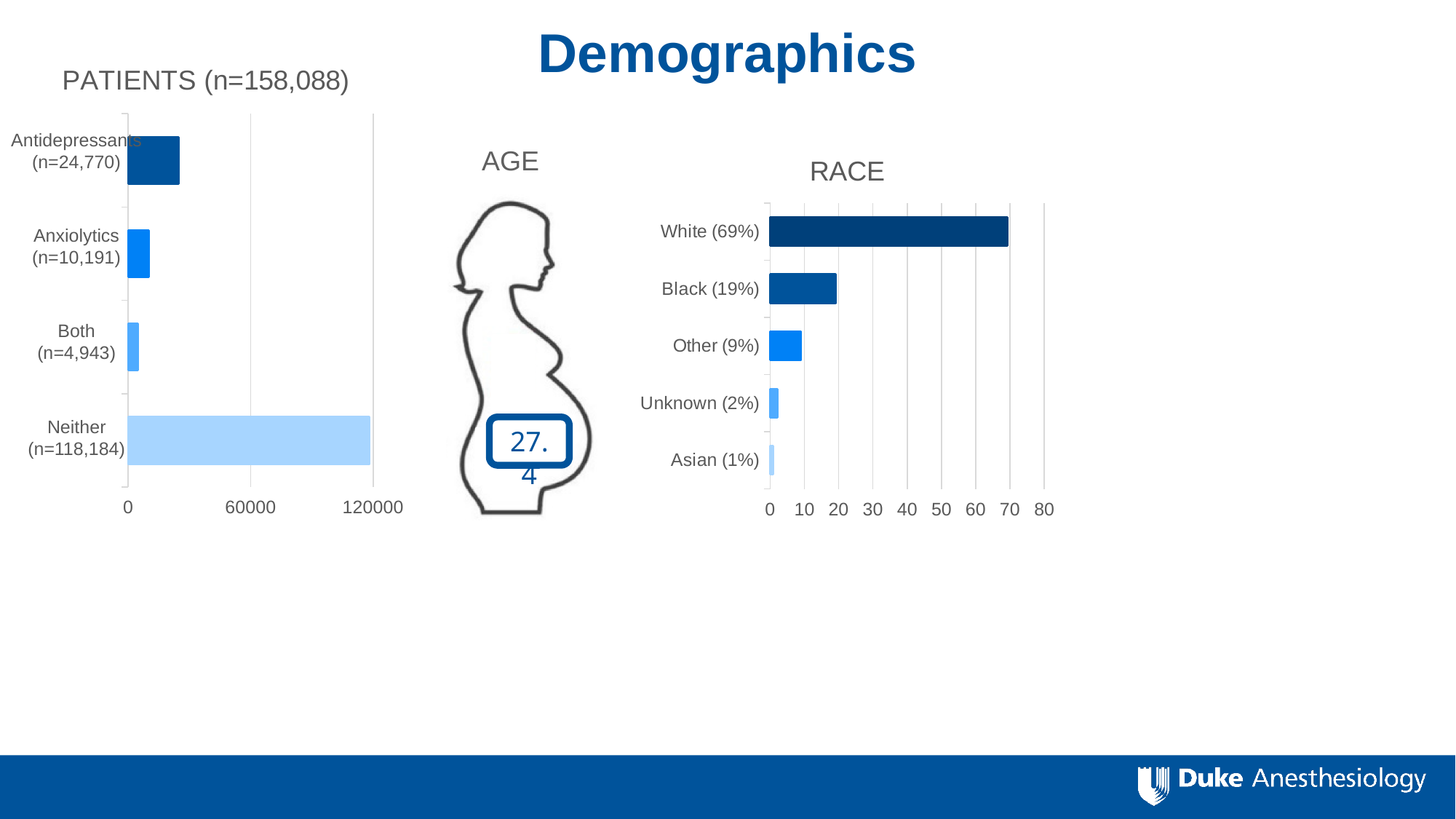
In the RACE chart, what is the difference between the White and Black percentages? 50% In the RACE chart, which category has the highest percentage? White In the PATIENTS (n=158,088) chart, how many patients are in the Anxiolytics category? 10,191 In the PATIENTS (n=158,088) chart, how many patients are in the Neither category? 118,184 In the PATIENTS (n=158,088) chart, is the value for Antidepressants greater or less than 60000? less What type of chart is the RACE chart? Bar chart In the RACE chart, what percentage is shown for Black? 19% In the PATIENTS (n=158,088) chart, which category has the smallest number of patients? Both In the PATIENTS (n=158,088) chart, which category has the largest number of patients? Neither How many categories are shown in the PATIENTS (n=158,088) chart? 4 In the RACE chart, which category has the lowest percentage? Asian In the PATIENTS (n=158,088) chart, what is the difference between the Antidepressants and Anxiolytics counts? 14,579